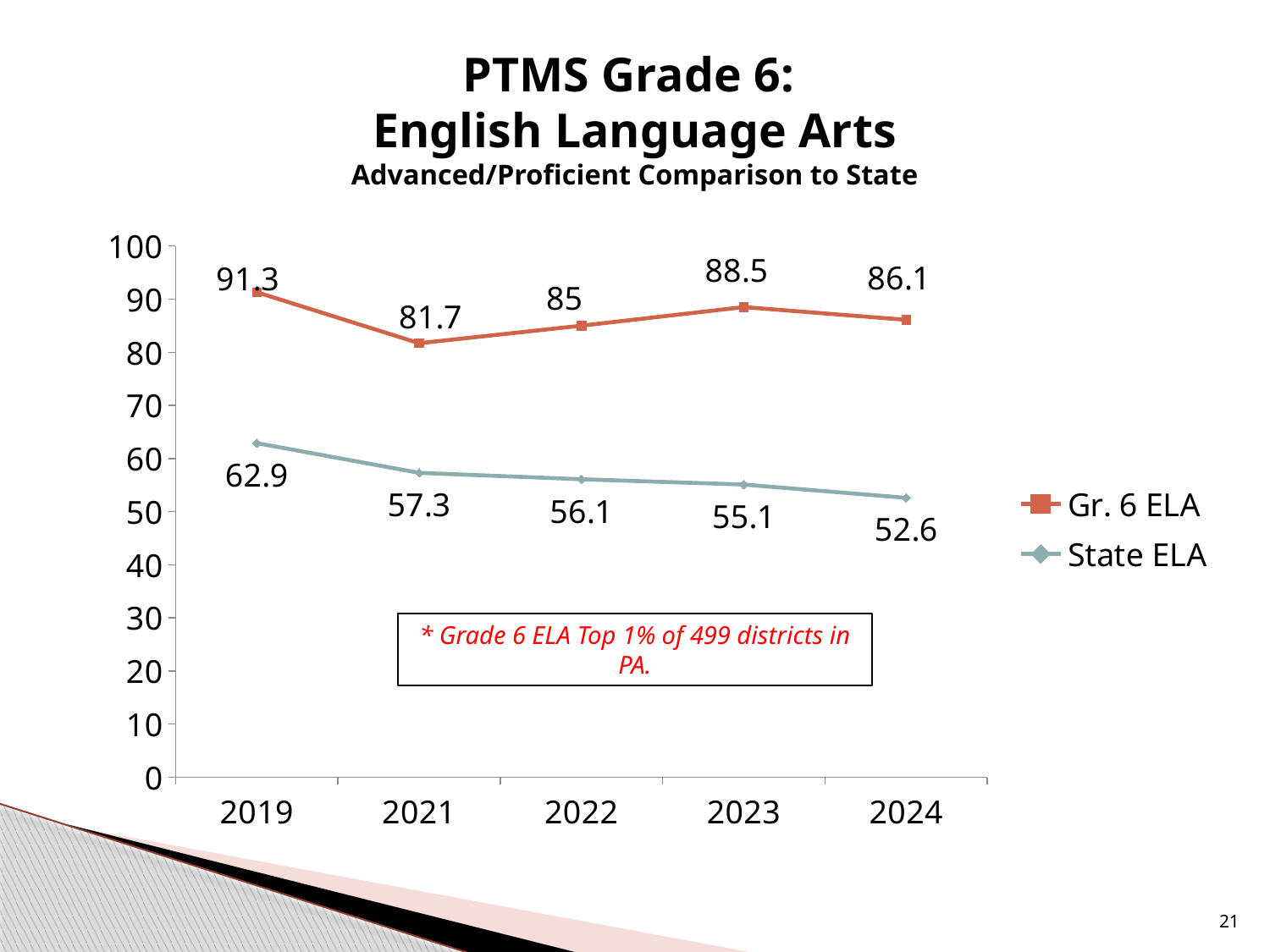
Which is larger in 2021: the Gr. 6 ELA value or the State ELA value? Gr. 6 ELA How many series does the legend list? 2 What kind of chart is shown on the slide? Line chart In which year is the State ELA value highest? 2019 What is the Gr. 6 ELA value for 2019? 91.3 Does the State ELA series rise or fall from 2019 to 2024? Fall What is the difference between the Gr. 6 ELA and State ELA values in 2023? 33.4 What is the State ELA value for 2024? 52.6 What is the subtitle shown below the chart title? Advanced/Proficient Comparison to State What is the Gr. 6 ELA value for 2022? 85 In which year is the Gr. 6 ELA value lowest? 2021 How many years are shown on the x axis? 5